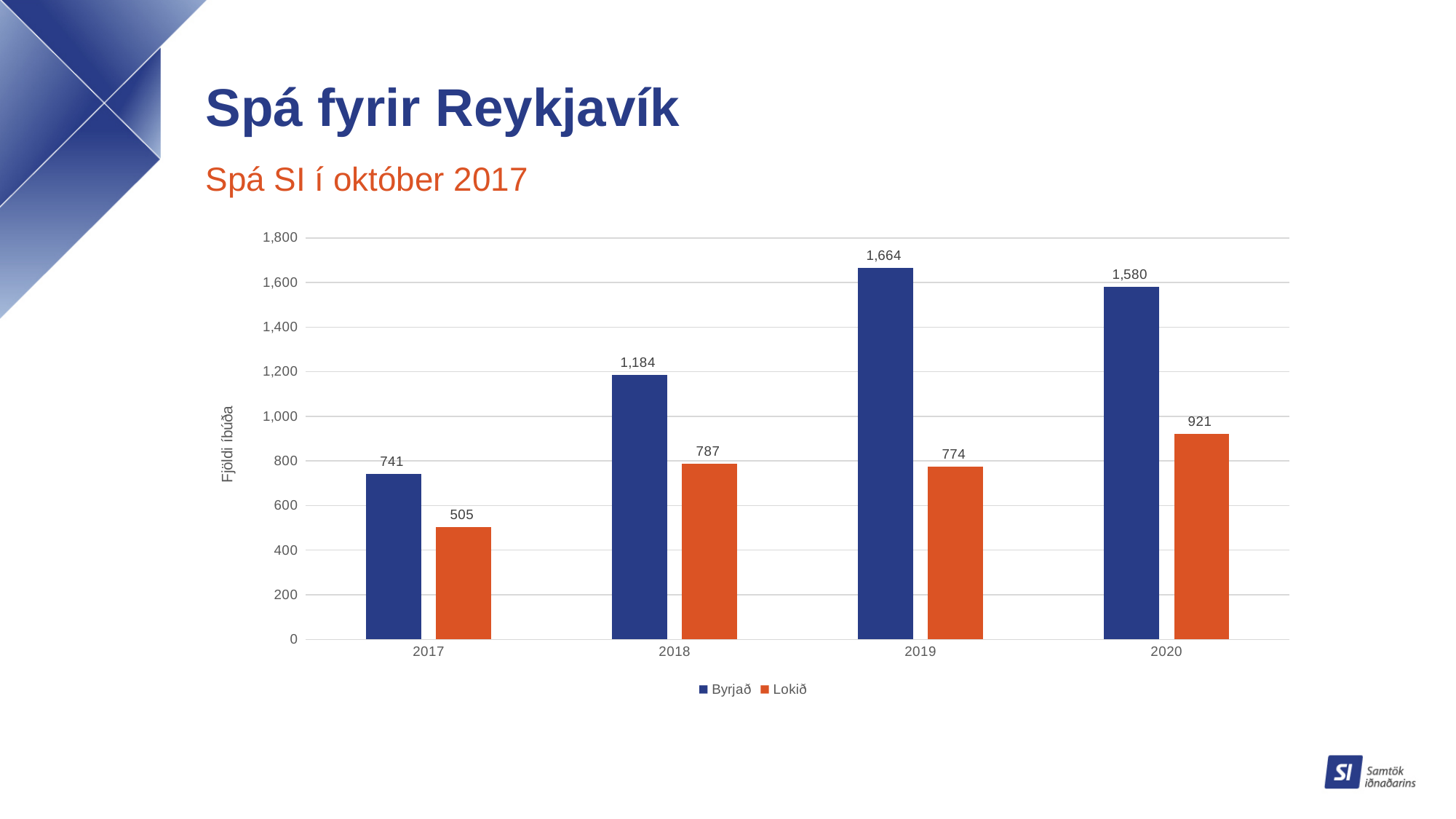
Is the value for Byrjað in 2018 greater or less than 1,000? greater What is the value for Lokið in 2020? 921 How many years are shown on the x axis? 4 Which year has the highest value for Byrjað? 2019 What is the difference between Byrjað and Lokið in 2018? 397 What kind of chart is shown on the slide? Bar chart Which year has the lowest value for Lokið? 2017 What is the value for Byrjað in 2019? 1,664 What is the value for Lokið in 2017? 505 Which is larger in 2020, Byrjað or Lokið? Byrjað How many series does the legend list? 2 What is the label on the vertical axis? Fjöldi íbúða